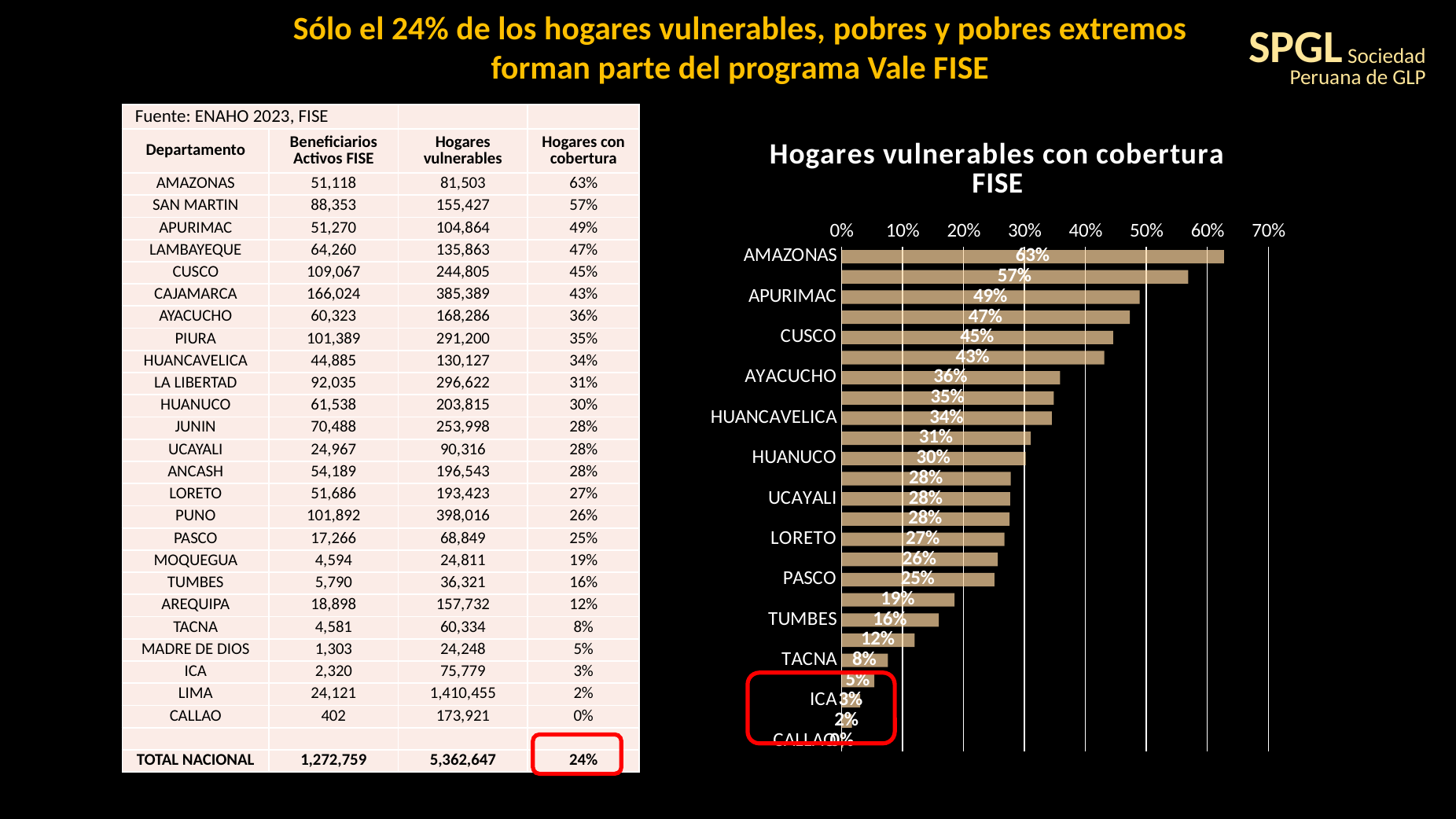
What is the difference between the values for APURIMAC and CUSCO? 4% What is the value for TACNA in the chart? 8% Which department has the highest value in the chart? AMAZONAS What is the value for AMAZONAS in the chart? 63% Which department has the lowest value in the chart? CALLAO What is the value for HUANCAVELICA in the chart? 34% Which has a larger value, AYACUCHO or HUANUCO? AYACUCHO How many bars are plotted in the chart? 25 Do the values rise or fall going down the chart from AMAZONAS to CALLAO? fall Is the value for LORETO greater or less than 30%? less What type of chart is shown on the slide? bar chart What is the title of the chart? Hogares vulnerables con cobertura FISE